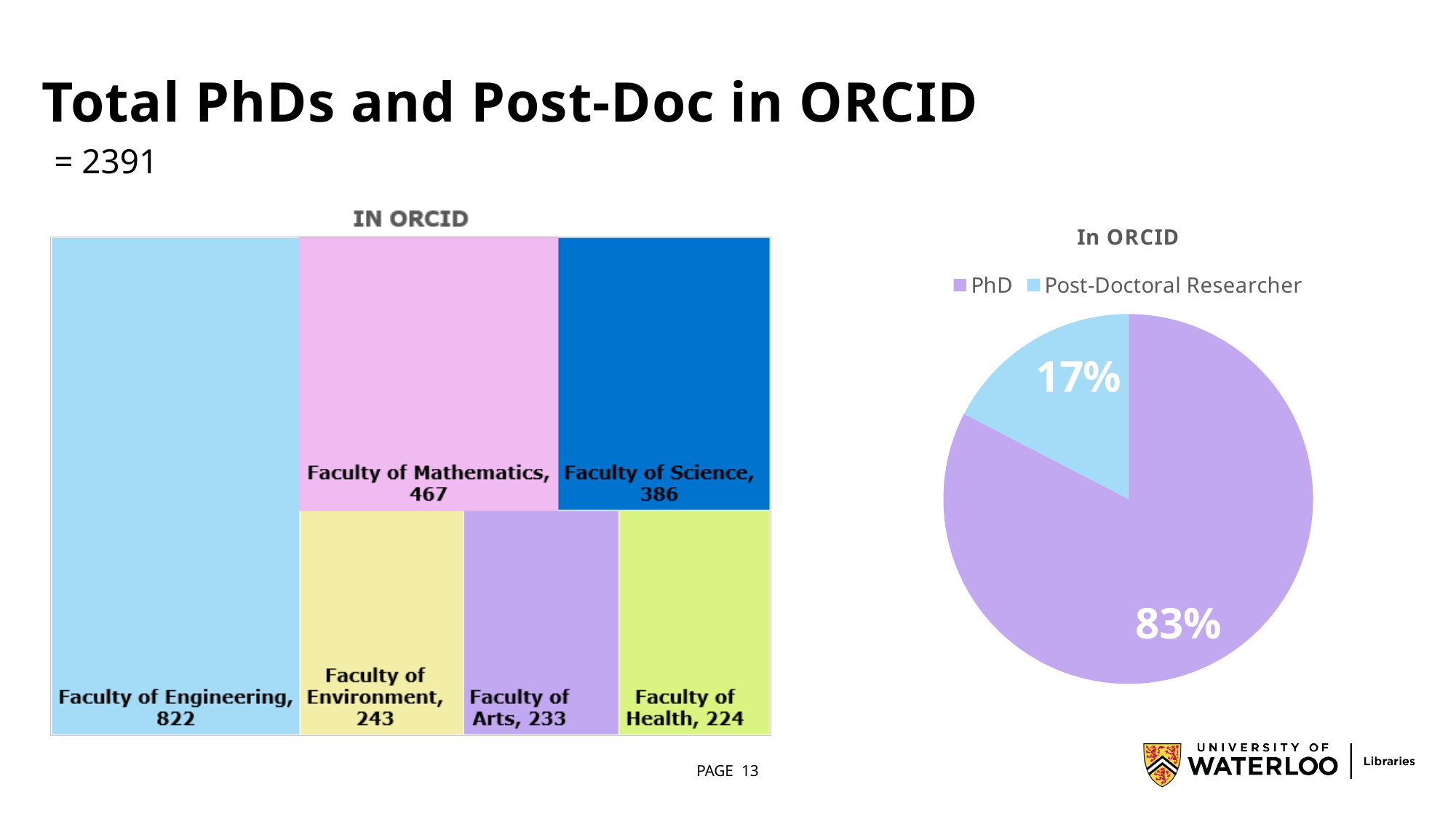
In the treemap chart on the left, which is larger: Faculty of Environment or Faculty of Arts? Faculty of Environment In the treemap chart on the left, which faculty has the highest value? Faculty of Engineering In the treemap chart on the left, what is the value for Faculty of Engineering? 822 What kind of chart is the chart on the right titled 'In ORCID'? Pie chart In the pie chart on the right, what share is PhD? 83% In the pie chart on the right, what share is Post-Doctoral Researcher? 17% How many entries does the legend of the pie chart on the right list? 2 In the treemap chart on the left, what is the difference between Faculty of Engineering and Faculty of Science? 436 In the treemap chart on the left, what is the value for Faculty of Health? 224 In the treemap chart on the left, what is the value for Faculty of Mathematics? 467 In the treemap chart on the left, which faculty has the lowest value? Faculty of Health How many faculties are shown in the treemap chart on the left? 6